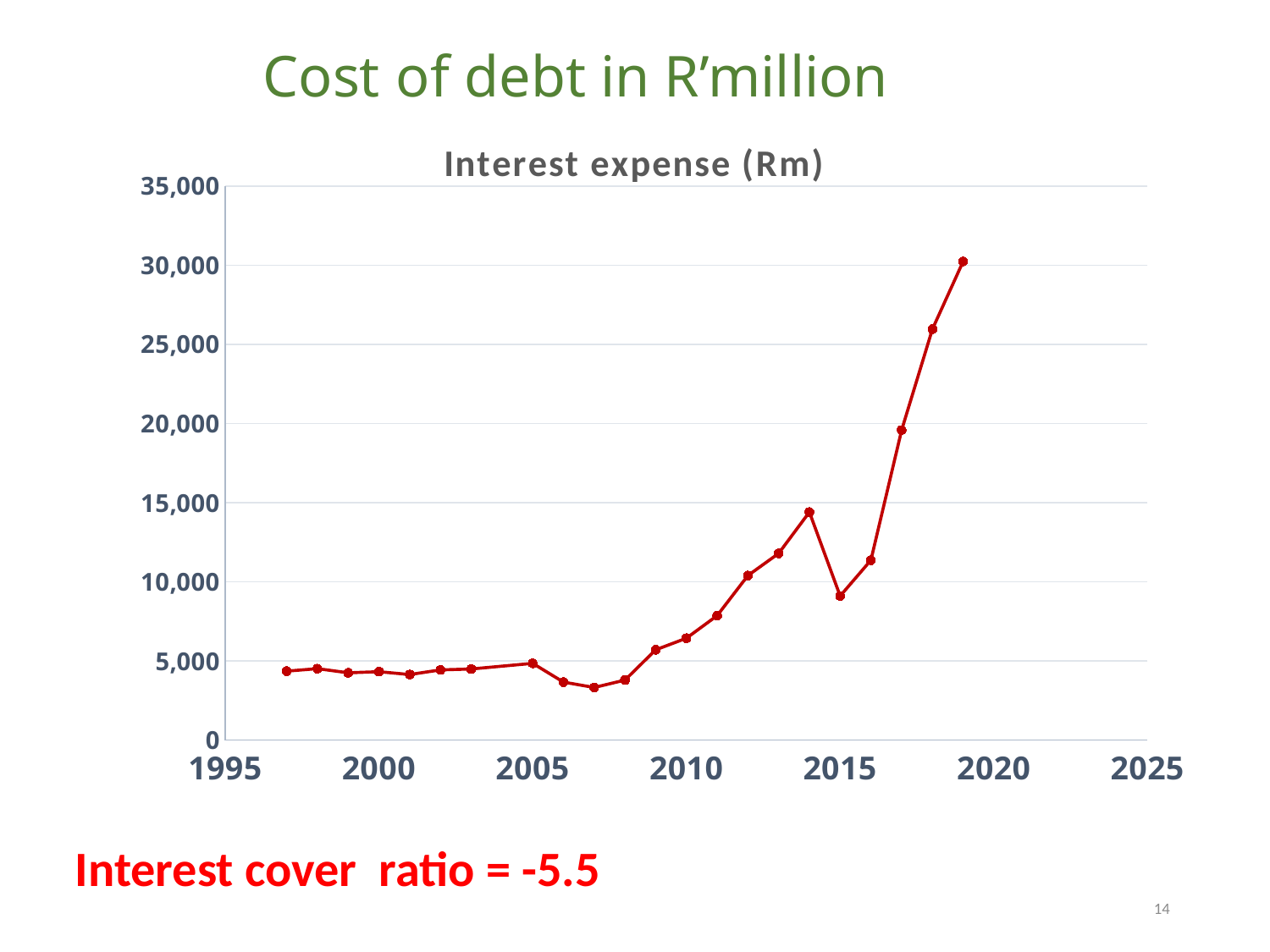
In which year is the interest expense highest? 2019 What kind of chart is shown on the slide? line chart In which year is the interest expense lowest? 2007 Is the interest expense for 2015 greater or less than 10,000? less Is the interest expense for 2013 greater or less than 10,000? greater Which year has the larger interest expense, 2014 or 2015? 2014 Overall, does the interest expense rise or fall from 1997 to 2019? rise Is the interest expense for 2007 greater or less than 5,000? less Which year has the larger interest expense, 2005 or 2010? 2010 What is the title of the chart? Interest expense (Rm)